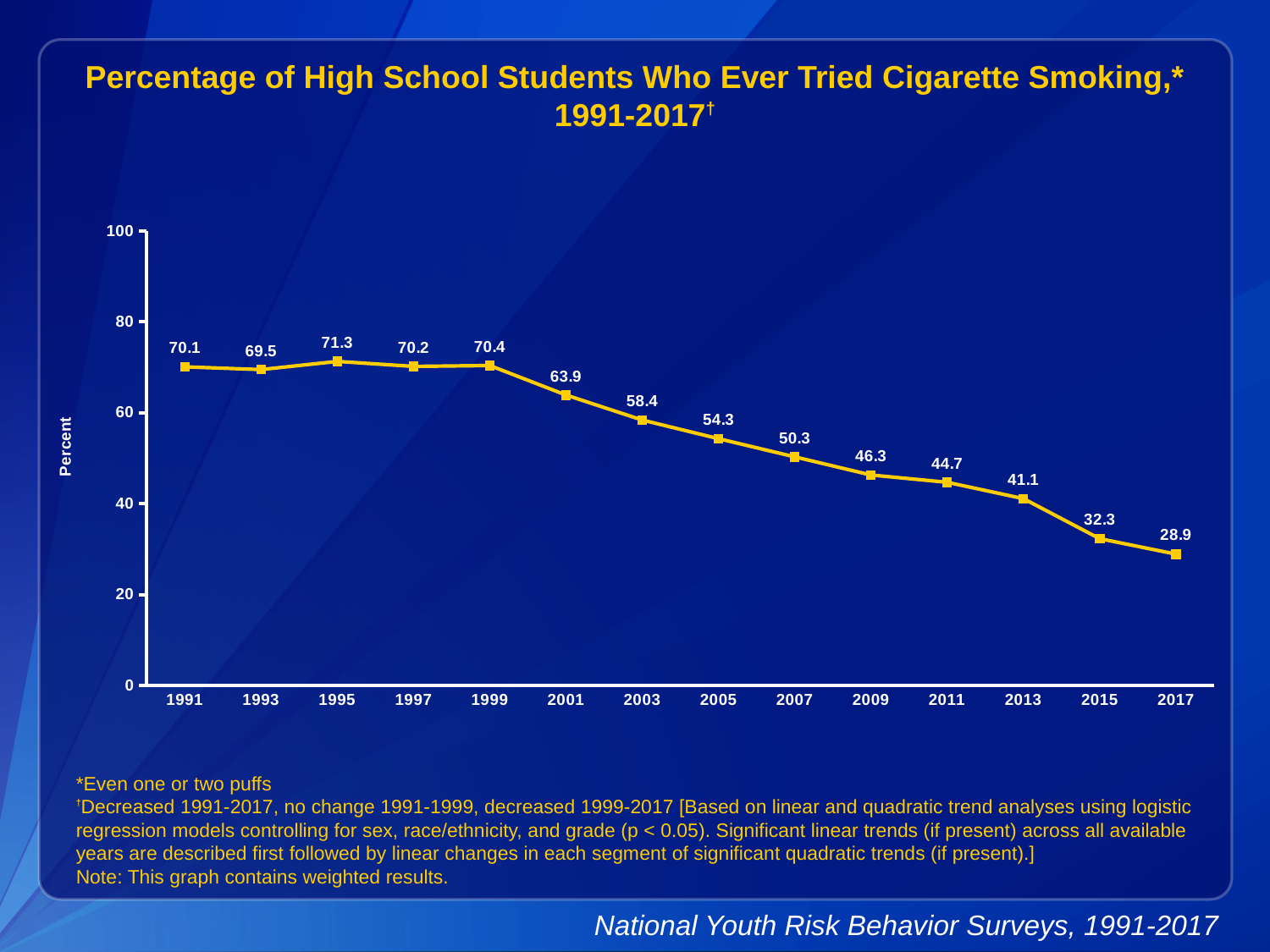
What is the difference between the values for 2013 and 2015? 8.8 What is the value for 2017? 28.9 Do the values rise or fall from 1999 to 2017? Fall How many years are plotted on the chart? 14 What kind of chart is this? Line chart Which is larger, the value for 2001 or the value for 2009? 2001 What is the value for 1991? 70.1 Which year has the lowest value? 2017 What is the label on the y axis? Percent What is the difference between the values for 1991 and 2017? 41.2 Which year has the highest value? 1995 What is the value for 2005? 54.3